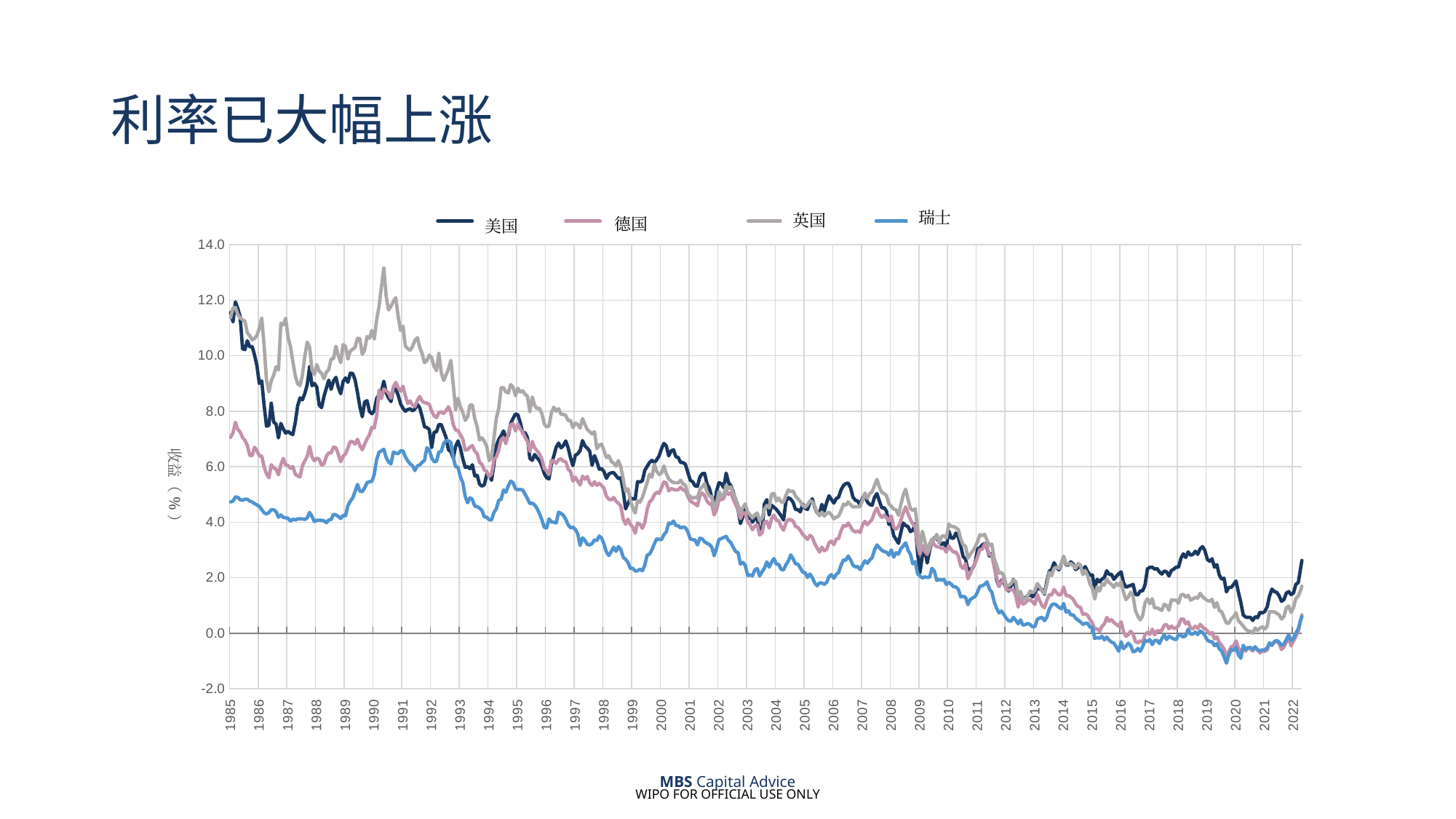
Which series reaches the highest value around 1990? 英国 What kind of chart is shown on the slide? line chart How many series does the legend list? 4 Is the peak value for 英国 around 1990 greater or less than 12.0? greater Which series has the lowest value in 1985? 瑞士 Overall, do the values rise or fall from 1985 to 2020? fall What is the highest value shown on the y axis? 14.0 Is the value for 美国 at the end of 2022 greater or less than 2.0? greater Which series are listed in the legend? 美国, 德国, 英国, 瑞士 In 1985, which is higher, 美国 or 德国? 美国 Is the value for 瑞士 in 1985 greater or less than 6.0? less